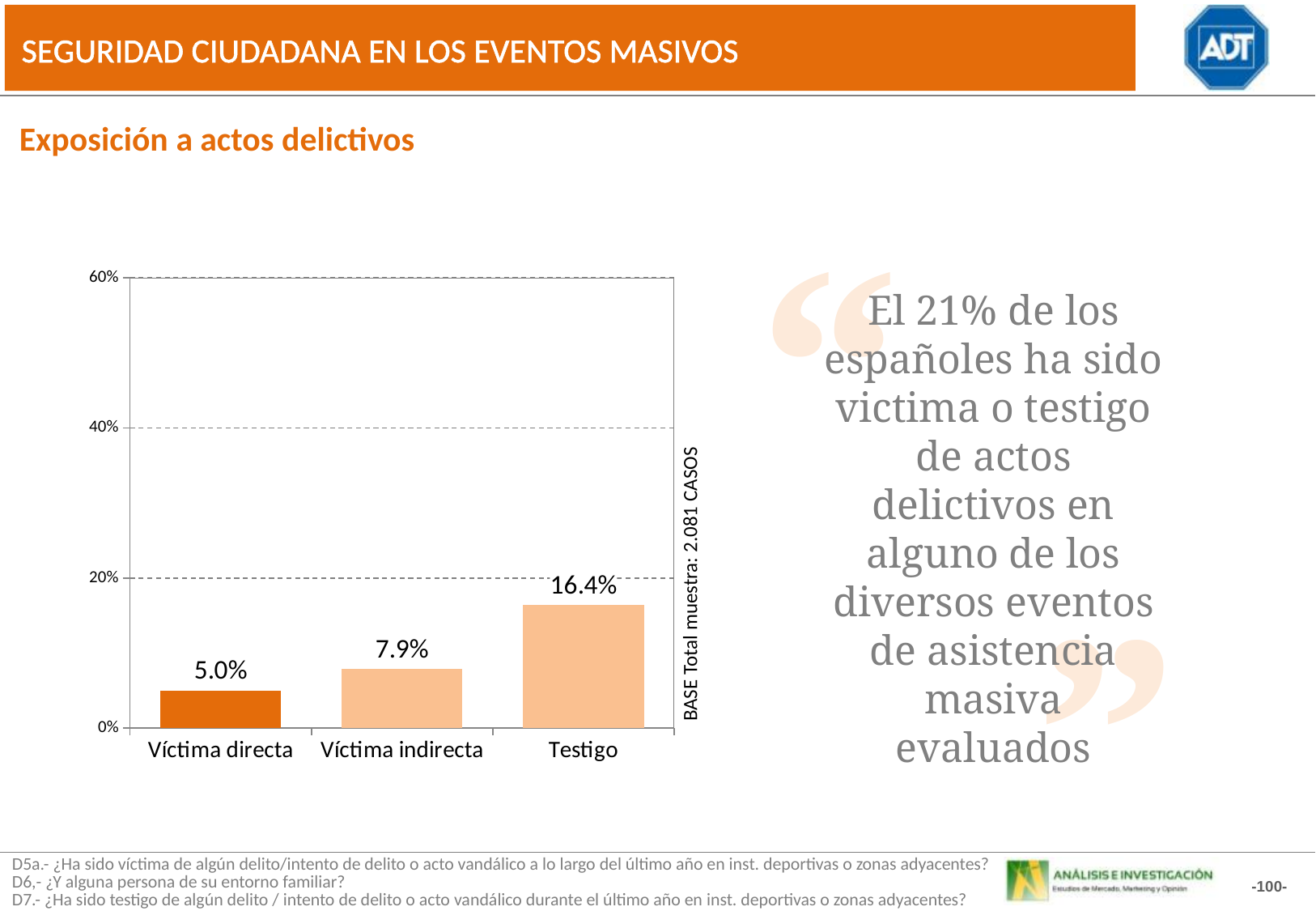
What is the difference between the values for Testigo and Víctima directa? 11.4% Which category has the highest value? Testigo What is the difference between the values for Víctima indirecta and Víctima directa? 2.9% What is the value for Víctima directa? 5.0% Which category has the lowest value? Víctima directa What kind of chart is shown on the slide? bar chart How many categories are shown on the x axis? 3 Is the value for Testigo greater or less than 20%? less Do the values rise or fall from left to right along the x axis? rise What is the value for Testigo? 16.4% Which is larger, the value for Víctima indirecta or the value for Testigo? Testigo What is the value for Víctima indirecta? 7.9%